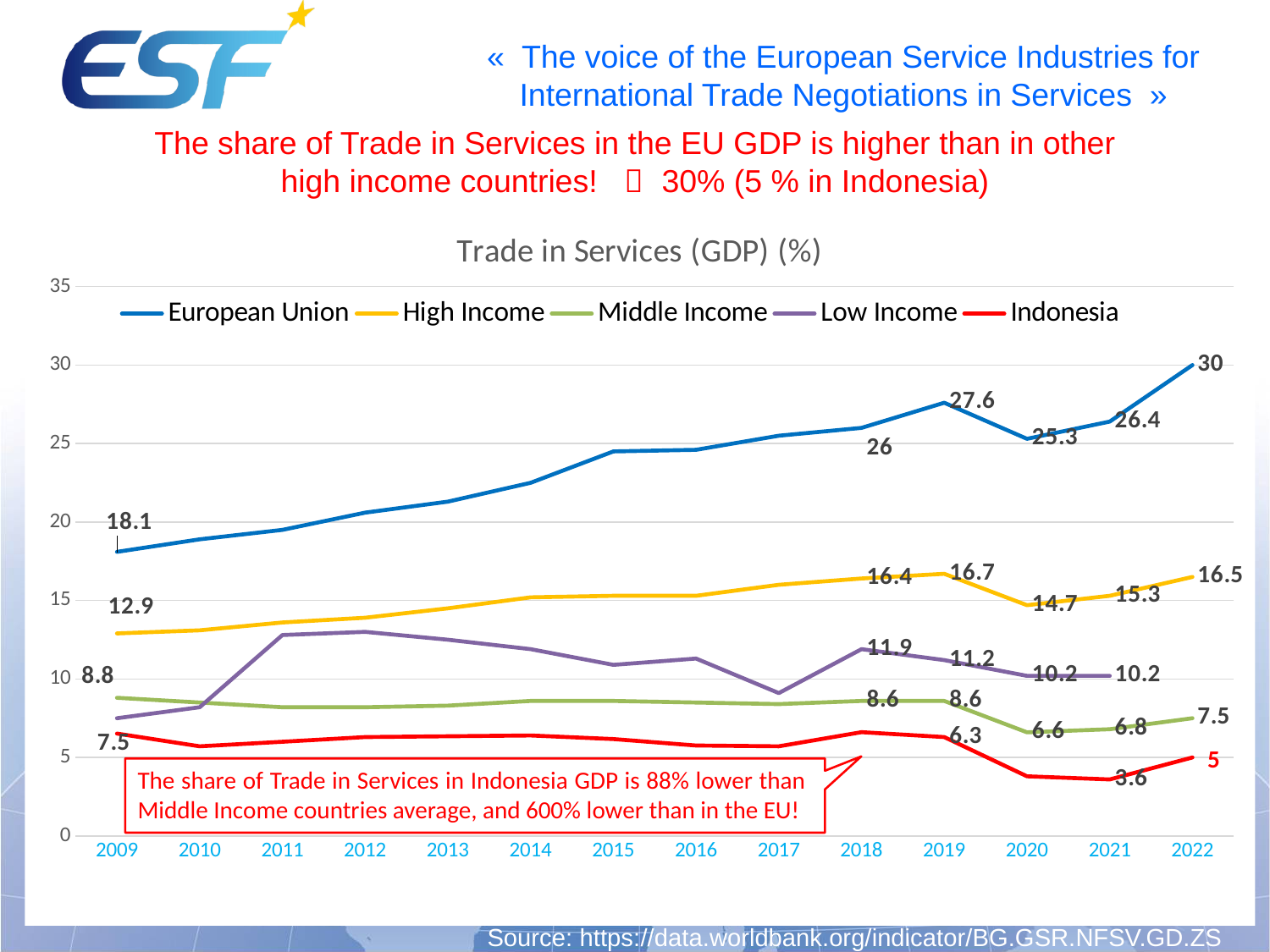
What is the value for High Income in 2019? 16.7 What is the value for Indonesia in 2021? 3.6 What is the value for Low Income in 2018? 11.9 Is the value for the European Union in 2015 greater or less than 20? greater What is the value for the European Union in 2022? 30 By how much did the European Union value increase from 2009 to 2022? 11.9 How many years are shown on the x axis? 14 Which is larger for the European Union: the 2019 value or the 2020 value? 2019 How many series does the legend list? 5 What kind of chart is shown? line chart What is the value for Middle Income in 2020? 6.6 Which series has the highest value in 2022? European Union